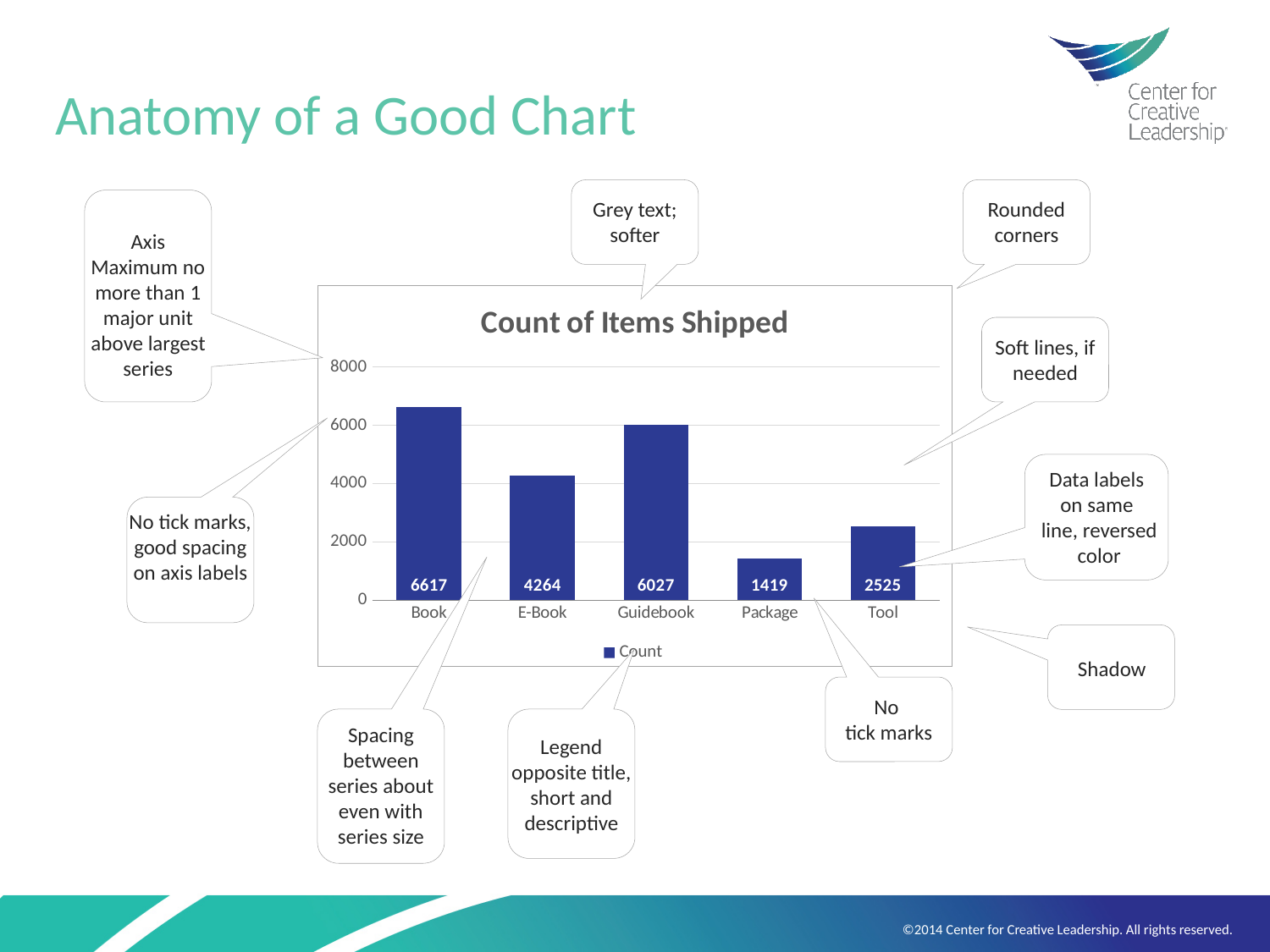
How many categories are shown on the x axis of the chart? 5 Which is larger, the value for E-Book or the value for Guidebook? Guidebook What is the difference between the values for Book and Guidebook? 590 Is the value for Tool greater or less than 2000? greater Which category has the highest count in the Count of Items Shipped chart? Book What is the value for Tool in the Count of Items Shipped chart? 2525 What is the difference between the values for E-Book and Tool? 1739 What kind of chart is shown on the slide? bar chart What is the value for Package in the Count of Items Shipped chart? 1419 How many series does the chart legend list? 1 What is the value for Book in the Count of Items Shipped chart? 6617 Which category has the lowest count in the Count of Items Shipped chart? Package